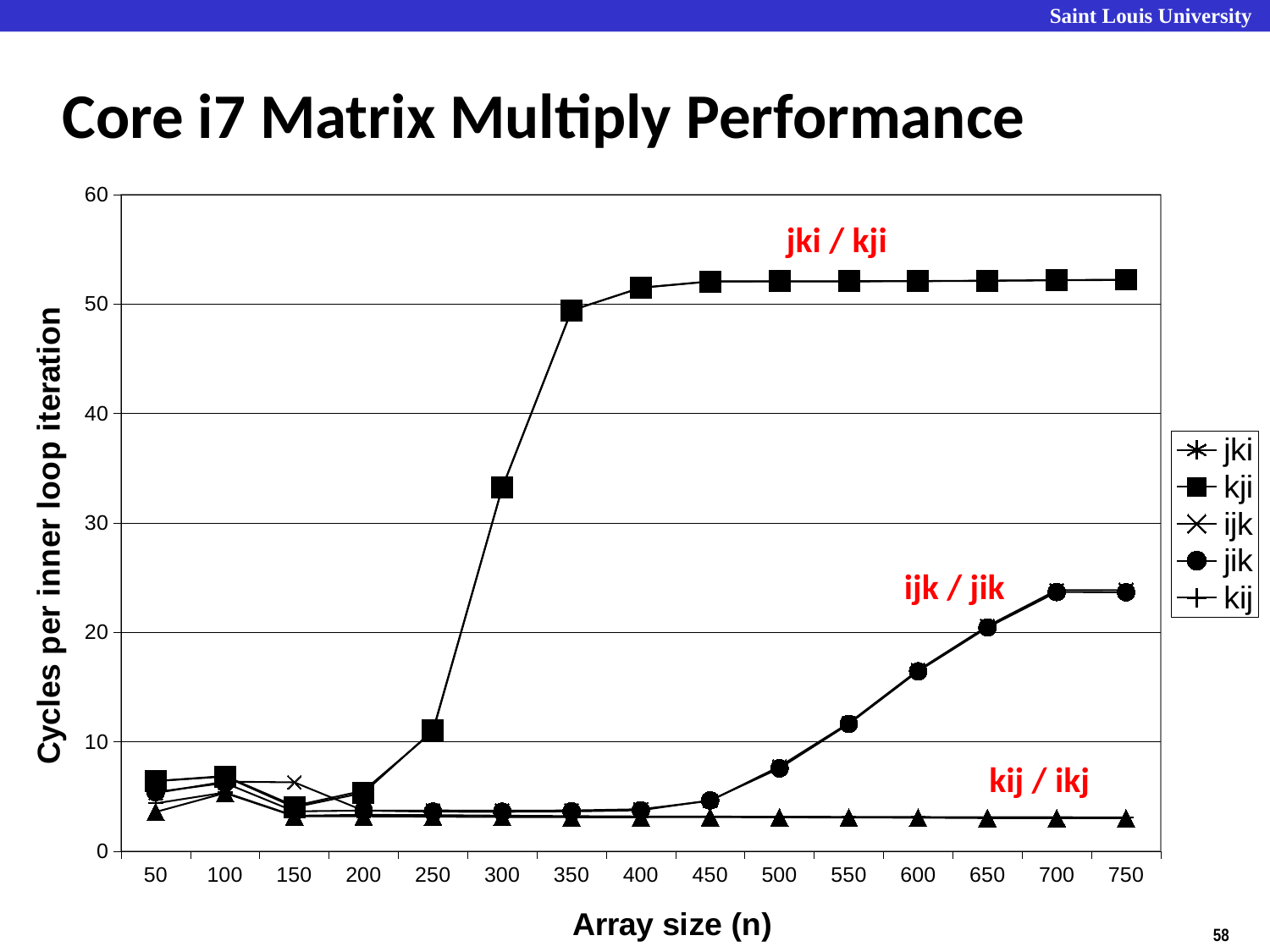
Is the value for jik at array size 600 greater or less than 10? greater How many array sizes are plotted along the x axis? 15 Is the value for kji at array size 750 greater or less than 50? greater What kind of chart is shown on the slide? line chart At array size 750, which is larger, the value for kji or the value for jik? kji Is the value for jik at array size 750 greater or less than 20? greater Does the kji series rise or fall as the array size goes from 200 to 400? rise What is the title of the x axis? Array size (n) How many series does the legend list? 5